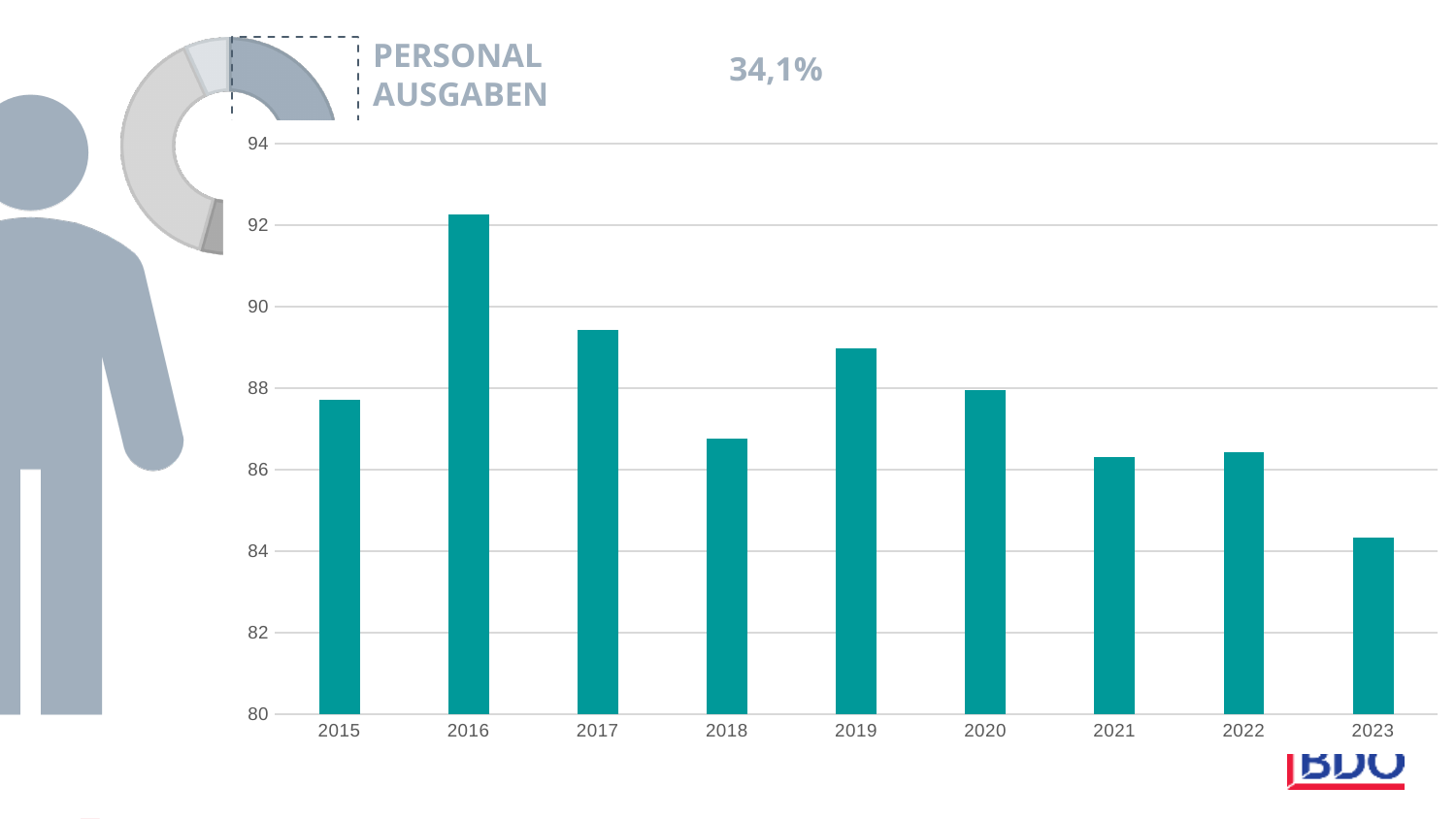
What percentage is printed next to the chart title? 34,1% How many years are shown on the x axis of the bar chart? 9 Which is larger, the value for 2019 or the value for 2020? 2019 Which year has the lowest bar in the chart? 2023 Is the value for 2016 greater or less than 90? greater Which year has the highest bar in the chart? 2016 Is the value for 2023 higher or lower than the value for 2015? lower What kind of chart is shown on the slide? bar chart Is the value for 2018 greater or less than 88? less Which is larger, the value for 2016 or the value for 2017? 2016 Is the value for 2023 greater or less than 86? less